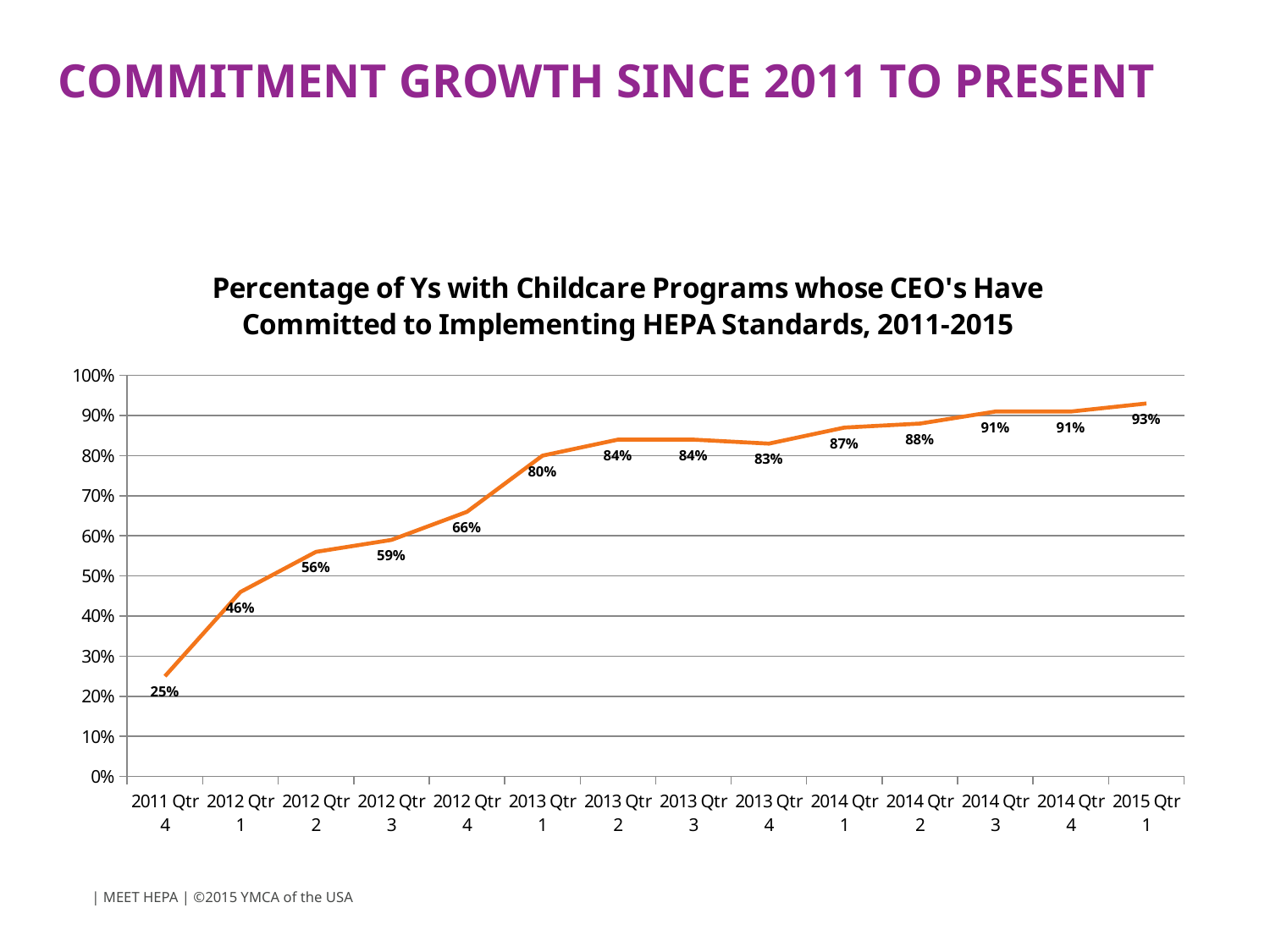
What is the value for 2015 Qtr 1? 93% What is the difference between the values for 2015 Qtr 1 and 2011 Qtr 4? 68% Do the values generally rise or fall from 2011 Qtr 4 to 2015 Qtr 1? Rise How many data points are plotted on the chart? 14 Which quarter has the lowest value? 2011 Qtr 4 Which quarter has the highest value? 2015 Qtr 1 What is the value for 2013 Qtr 1? 80% What is the value for 2011 Qtr 4? 25% Which is larger, the value for 2013 Qtr 2 or the value for 2013 Qtr 4? 2013 Qtr 2 What kind of chart is shown? Line chart What is the title of the chart? Percentage of Ys with Childcare Programs whose CEO's Have Committed to Implementing HEPA Standards, 2011-2015 What is the difference between the values for 2012 Qtr 4 and 2012 Qtr 3? 7%